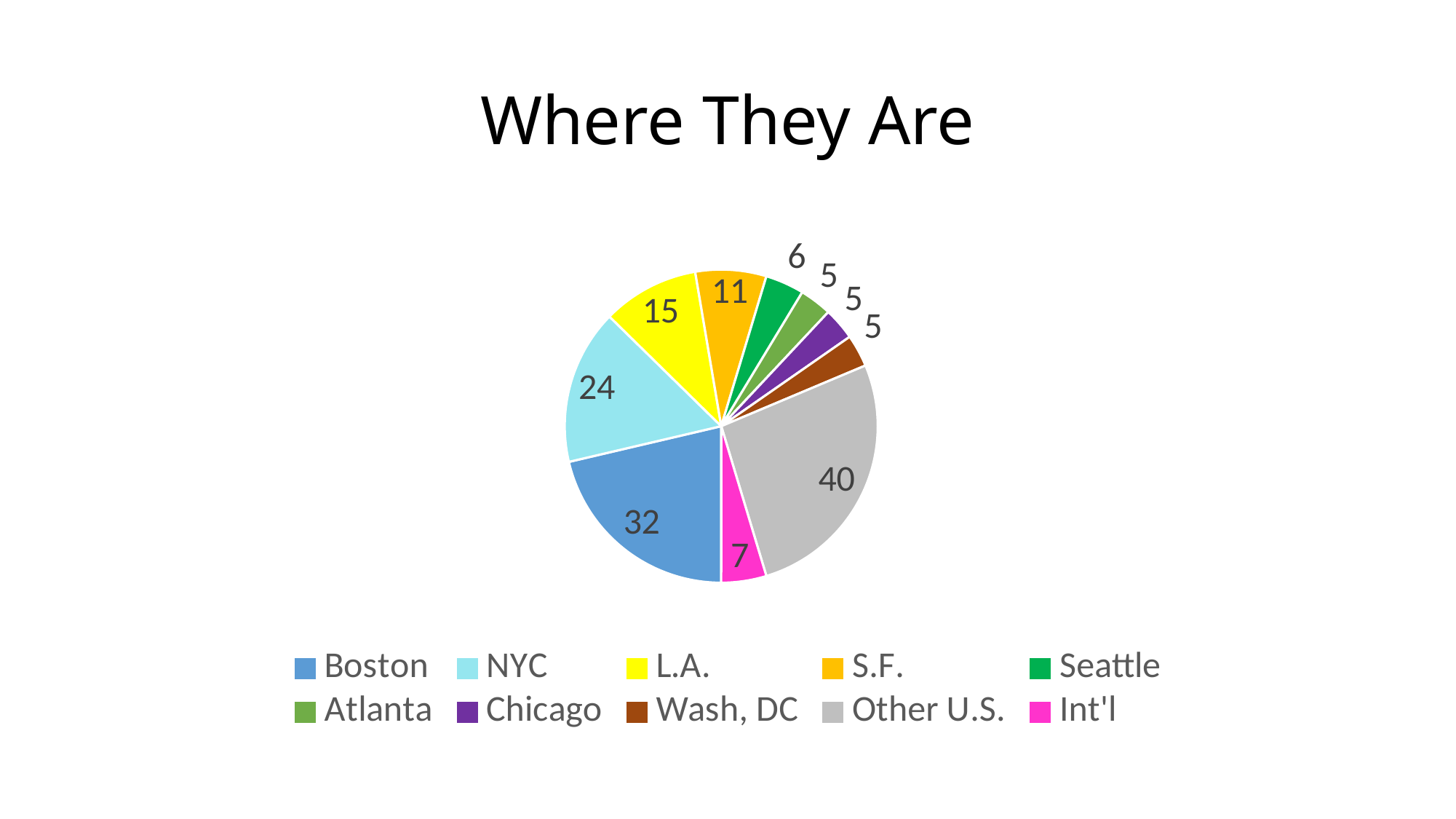
Which is larger, the value for L.A. or the value for S.F.? L.A. What is the value for Boston? 32 What is the title of the chart? Where They Are What type of chart is shown on the slide? pie chart Which category has the largest slice? Other U.S. What is the difference between the values for Other U.S. and Boston? 8 How many categories does the legend list? 10 What is the value for Other U.S.? 40 What is the value for NYC? 24 What is the value for Seattle? 6 What share of the pie does L.A. represent? 10% What is the value for Int'l? 7